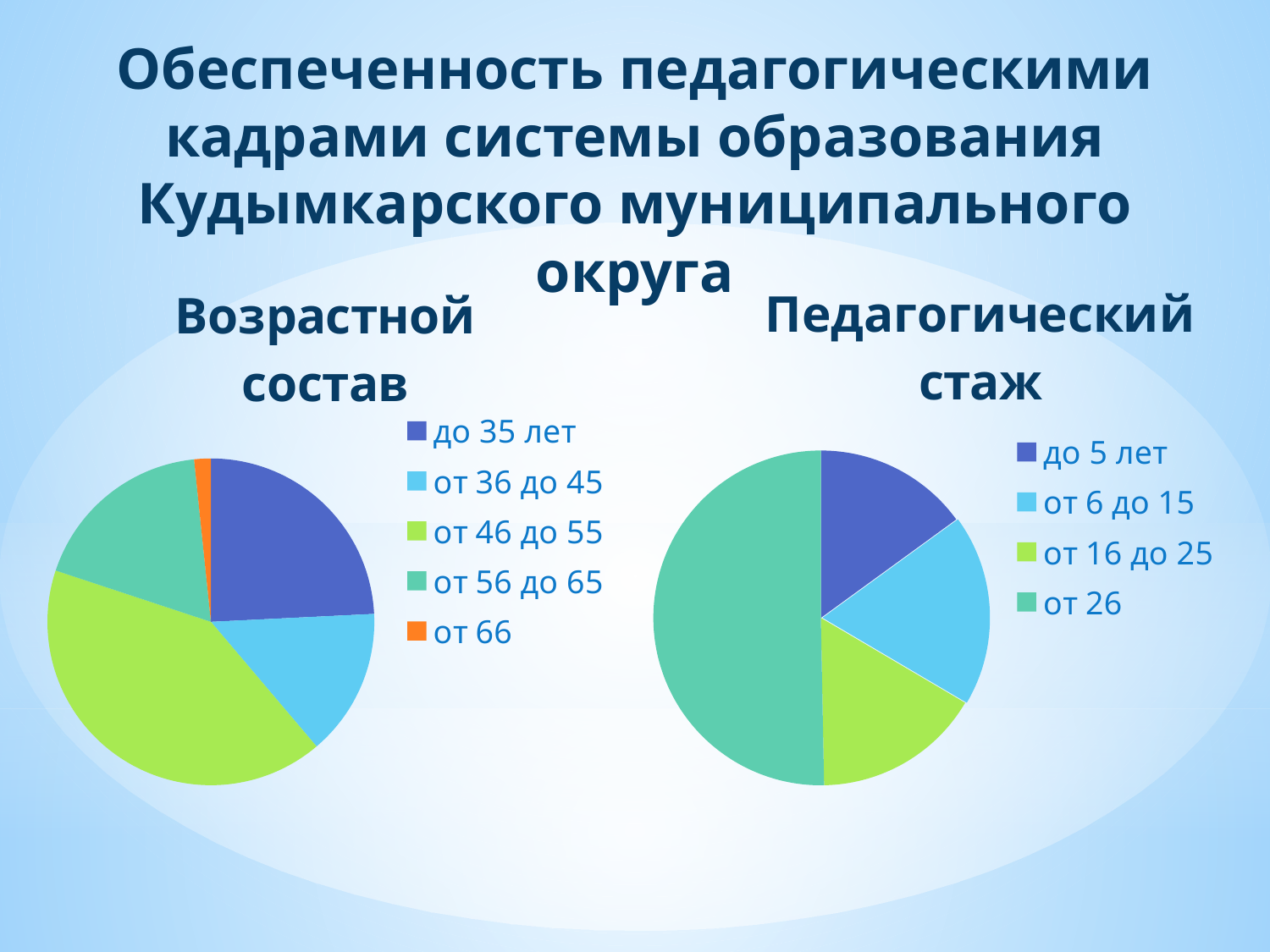
What is the title of the chart on the right side of the slide? Педагогический стаж In the "Педагогический стаж" chart, how many categories does the legend list? 4 In the "Возрастной состав" chart, which slice is larger: "до 35 лет" or "от 36 до 45"? до 35 лет In the "Возрастной состав" chart, which slice is larger: "от 56 до 65" or "от 66"? от 56 до 65 In the "Возрастной состав" chart, which category has the smallest slice? от 66 In the "Педагогический стаж" chart, which category has the largest slice? от 26 What type of chart is the "Педагогический стаж" chart? pie chart What type of chart is the "Возрастной состав" chart? pie chart In the "Возрастной состав" chart, what colour is the "от 66" slice? orange In the "Возрастной состав" chart, which category has the largest slice? от 46 до 55 In the "Педагогический стаж" chart, which slice is larger: "от 26" or "до 5 лет"? от 26 In the "Возрастной состав" chart, how many categories does the legend list? 5